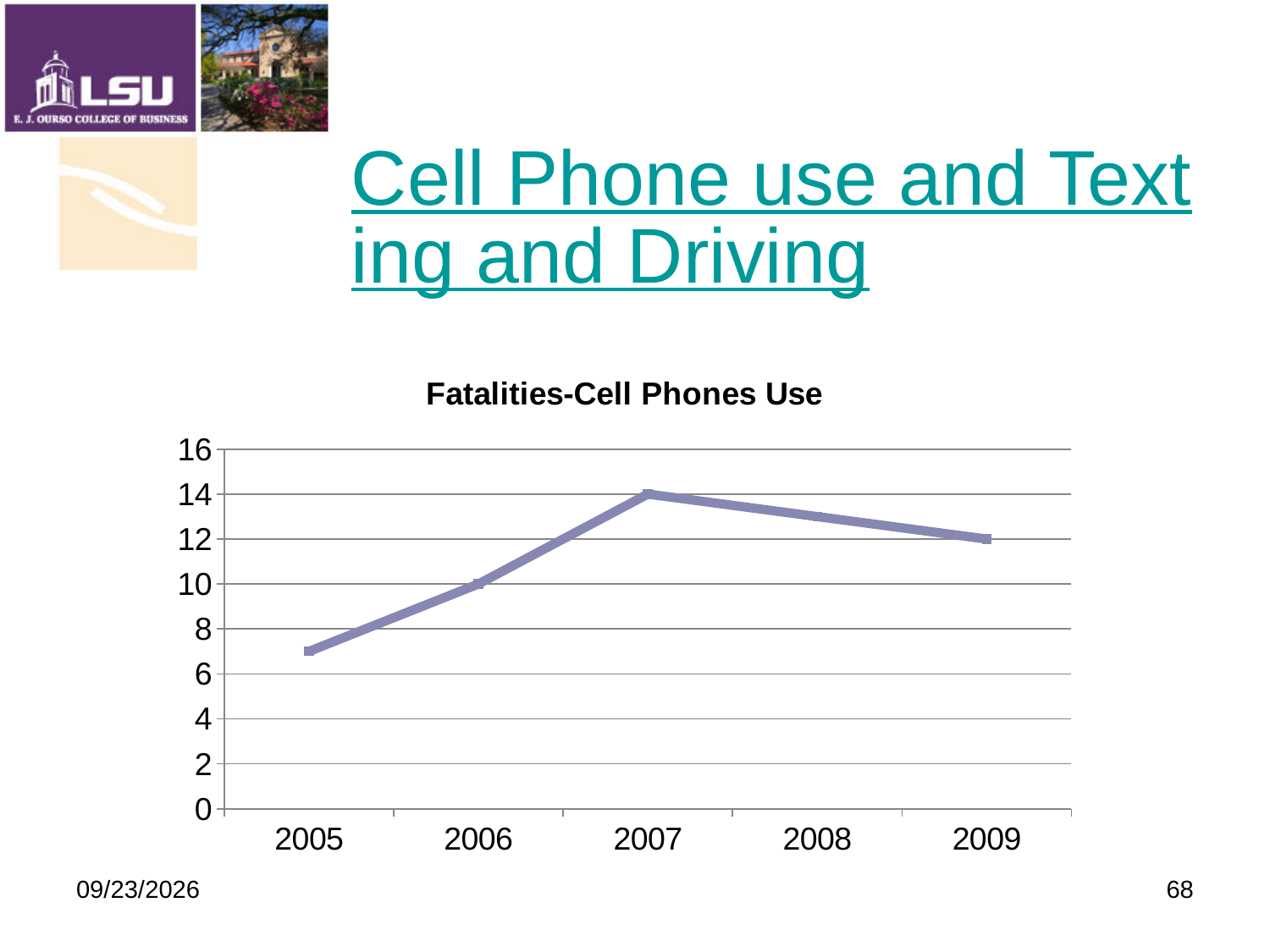
Which year has the lowest value in the chart? 2005 How does the value change from 2007 to 2009 in the chart? It falls What is the title of the chart? Fatalities-Cell Phones Use Is the value for 2005 greater or less than 8? less Is the value for 2008 greater or less than 12? greater What is the value for 2006 in the Fatalities-Cell Phones Use chart? 10 What type of chart is shown on the slide? Line chart What is the difference between the values for 2007 and 2006? 4 Which year has the highest value in the chart? 2007 What is the value for 2007 in the Fatalities-Cell Phones Use chart? 14 How many years are plotted on the x axis of the chart? 5 What is the value for 2009 in the Fatalities-Cell Phones Use chart? 12